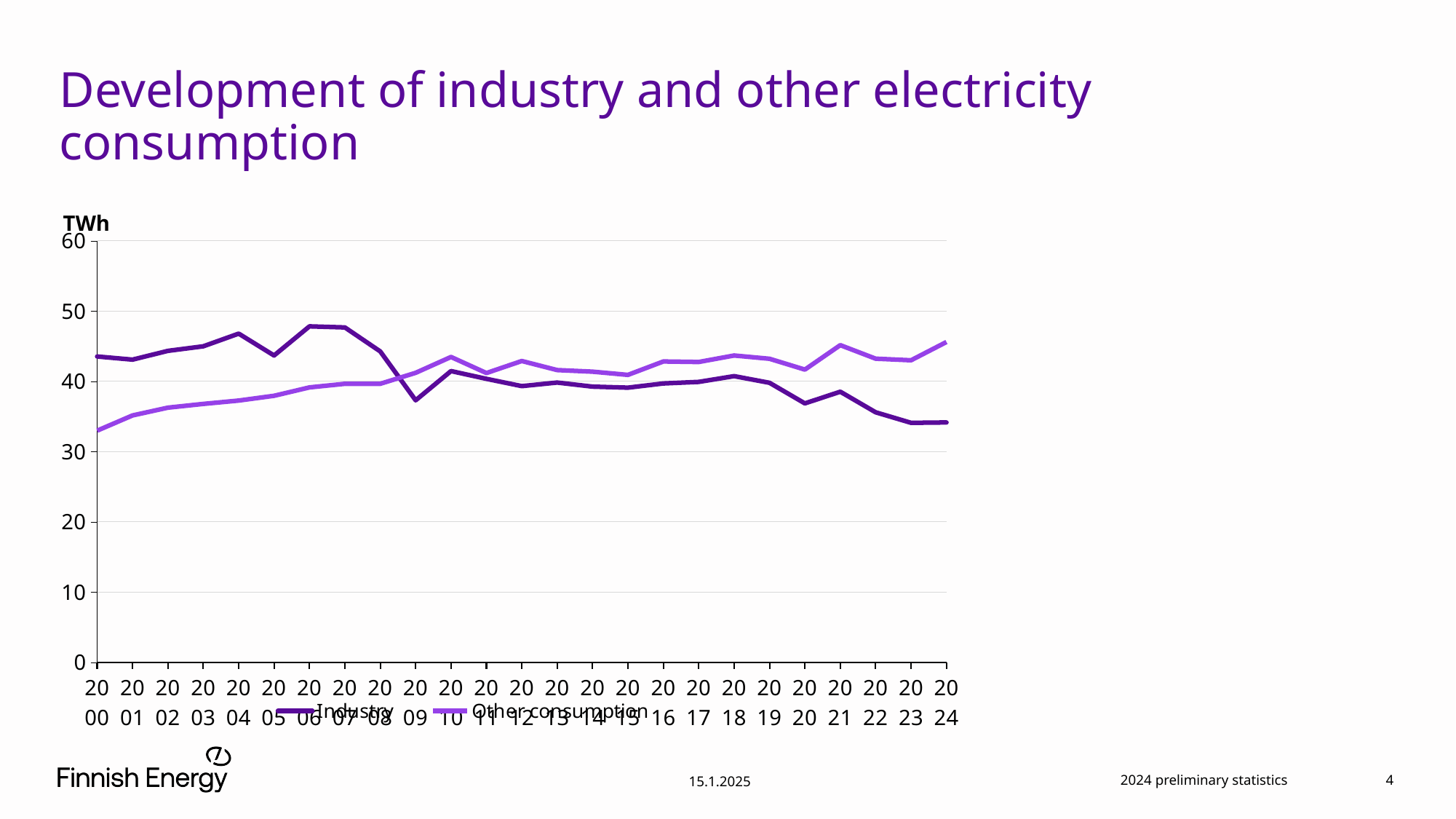
In 2024, which series has the larger value, Industry or Other consumption? Other consumption How many years are plotted along the x axis? 25 Is the value for Other consumption in 2024 greater or less than 40? greater How many series does the legend list? 2 In 2000, which series has the larger value, Industry or Other consumption? Industry Is the value for Industry in 2000 greater or less than 40? greater What kind of chart is shown on the slide? line chart What is the title of the chart on the slide? Development of industry and other electricity consumption Is the value for Other consumption in 2000 greater or less than 40? less What unit is shown on the y axis? TWh